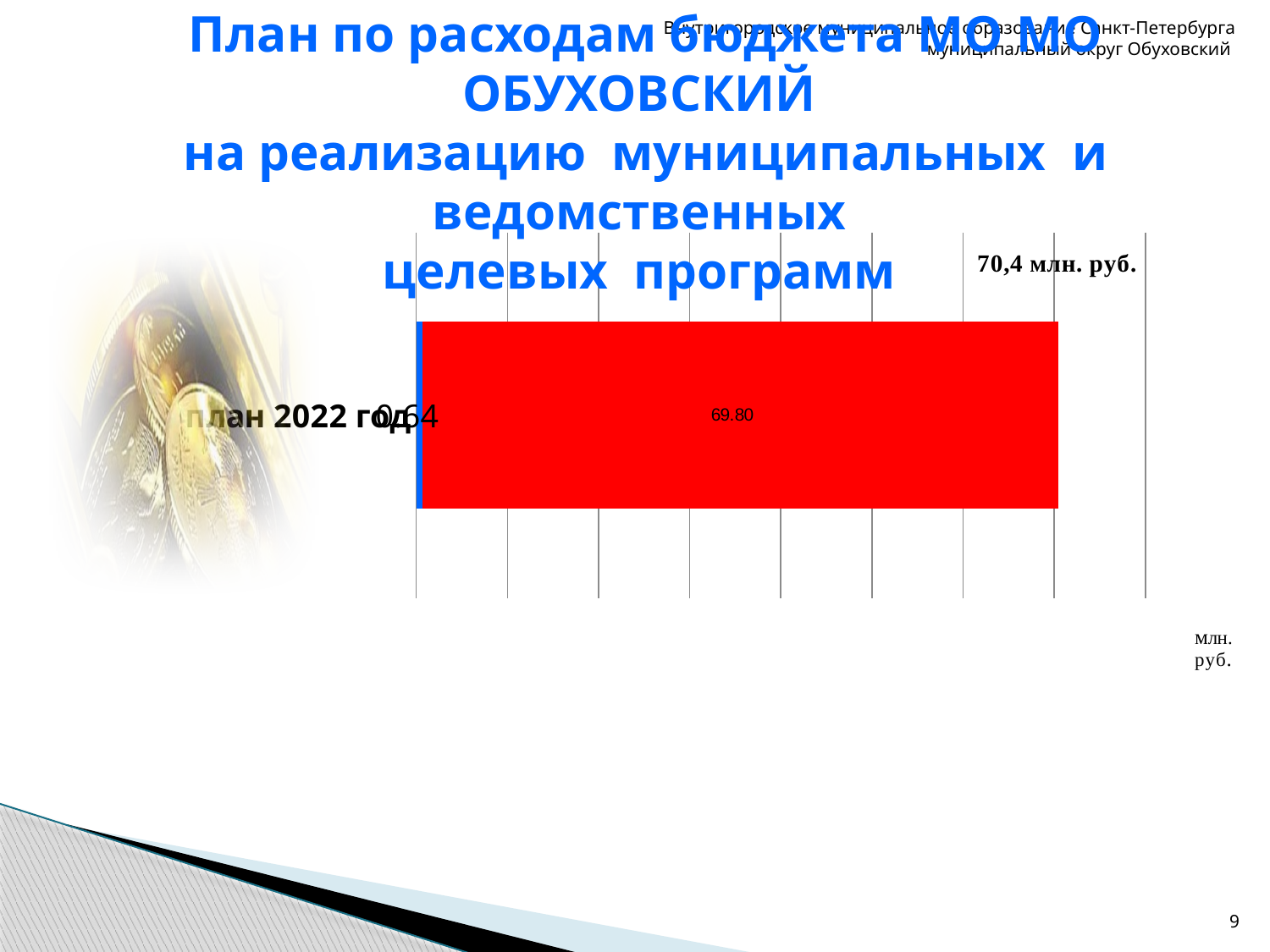
What total amount is printed in the text box above the bar? 70,4 млн. руб. What value is printed next to the thin blue bar for план 2022 год? 0.64 What value is printed on the red bar for план 2022 год? 69.80 What is the name of the single category on the chart? план 2022 год How many categories are plotted on the chart? 1 What kind of chart is shown on the slide? bar chart Which bar is longer, the red bar or the blue bar? red What is the difference between the red bar value and the blue bar value for план 2022 год? 69.16